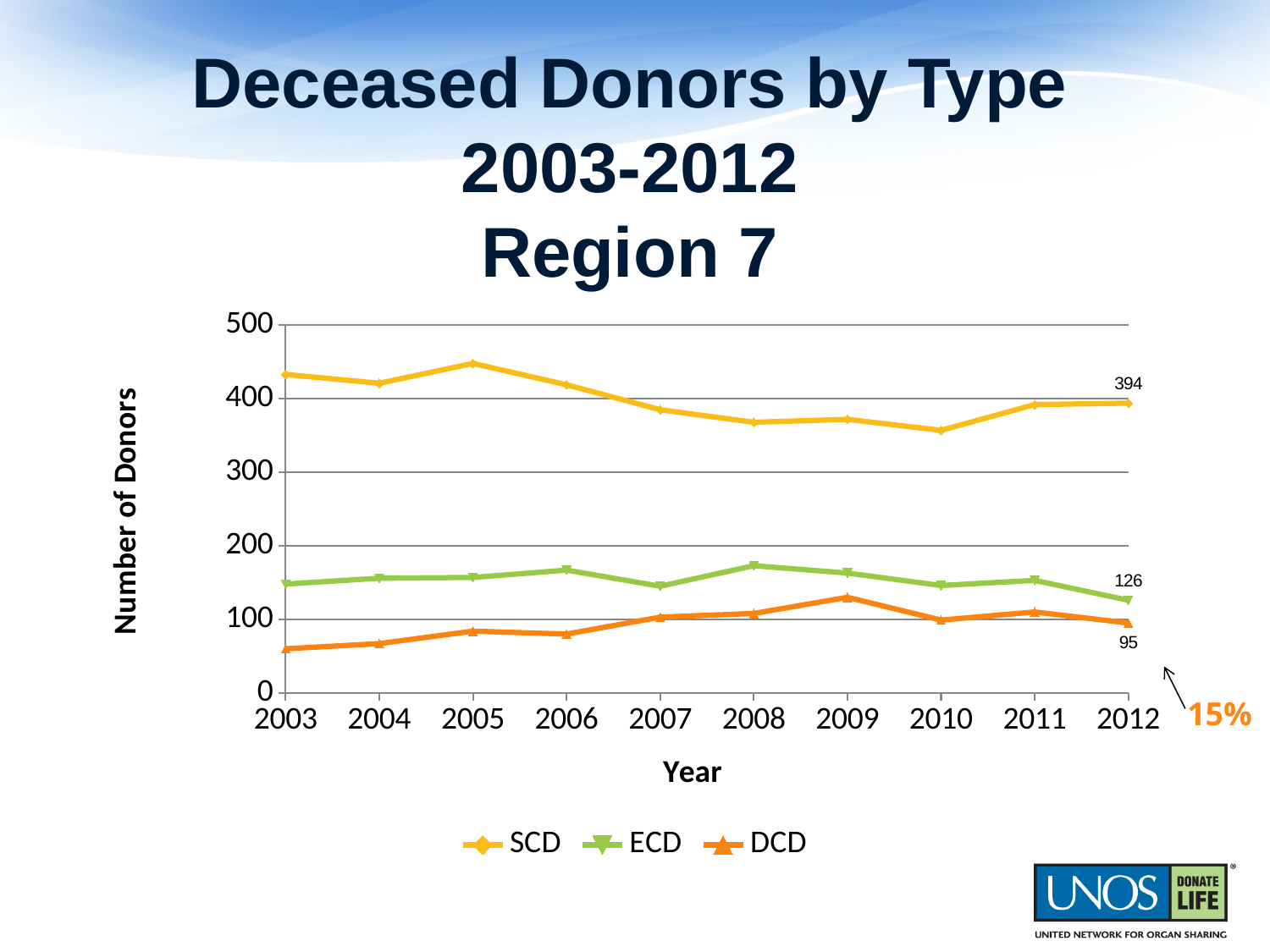
What is the difference between the SCD and ECD values in 2012? 268 What kind of chart is shown on the slide? Line chart How many series does the legend list? 3 Is the value for SCD in 2005 greater or less than 400? greater How many years are shown on the x axis? 10 What is the value for DCD in 2012? 95 Which series has the lowest value in 2012? DCD What is the value for SCD in 2012? 394 What is the value for ECD in 2012? 126 Is the value for DCD in 2003 greater or less than 100? less What is the difference between the ECD and DCD values in 2012? 31 Which series has the highest value in 2012? SCD